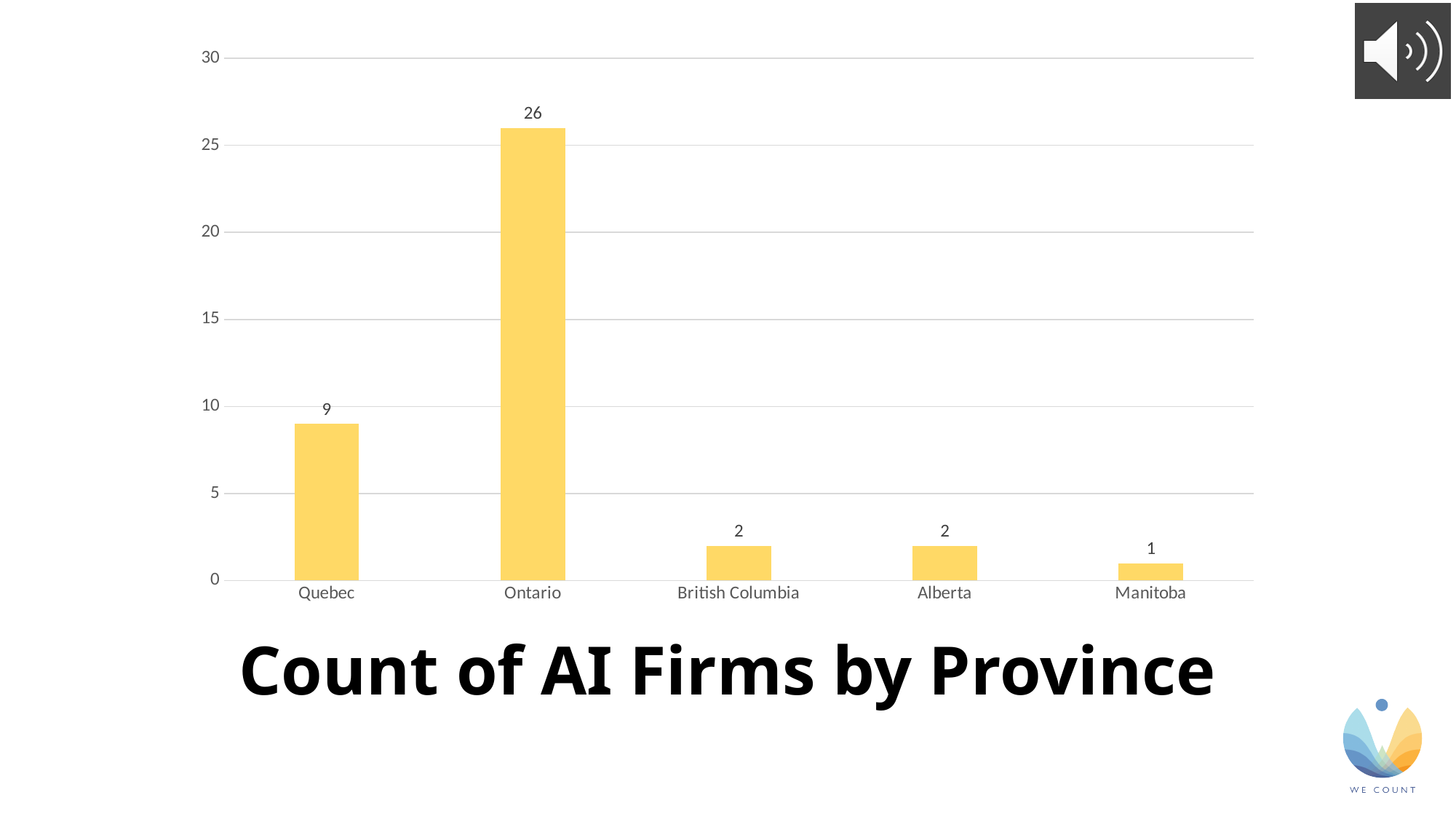
Which province has the highest count of AI firms? Ontario What is the count of AI firms for Ontario? 26 How many provinces are shown on the chart? 5 Which province has the lowest count of AI firms? Manitoba What is the difference between the counts for Ontario and Quebec? 17 What is the total count of AI firms across all five provinces? 40 What is the title of the chart? Count of AI Firms by Province What is the count of AI firms for Manitoba? 1 Is the value for Ontario greater or less than 25? greater Which has more AI firms, Quebec or British Columbia? Quebec What is the count of AI firms for Quebec? 9 What kind of chart is shown on the slide? Bar chart